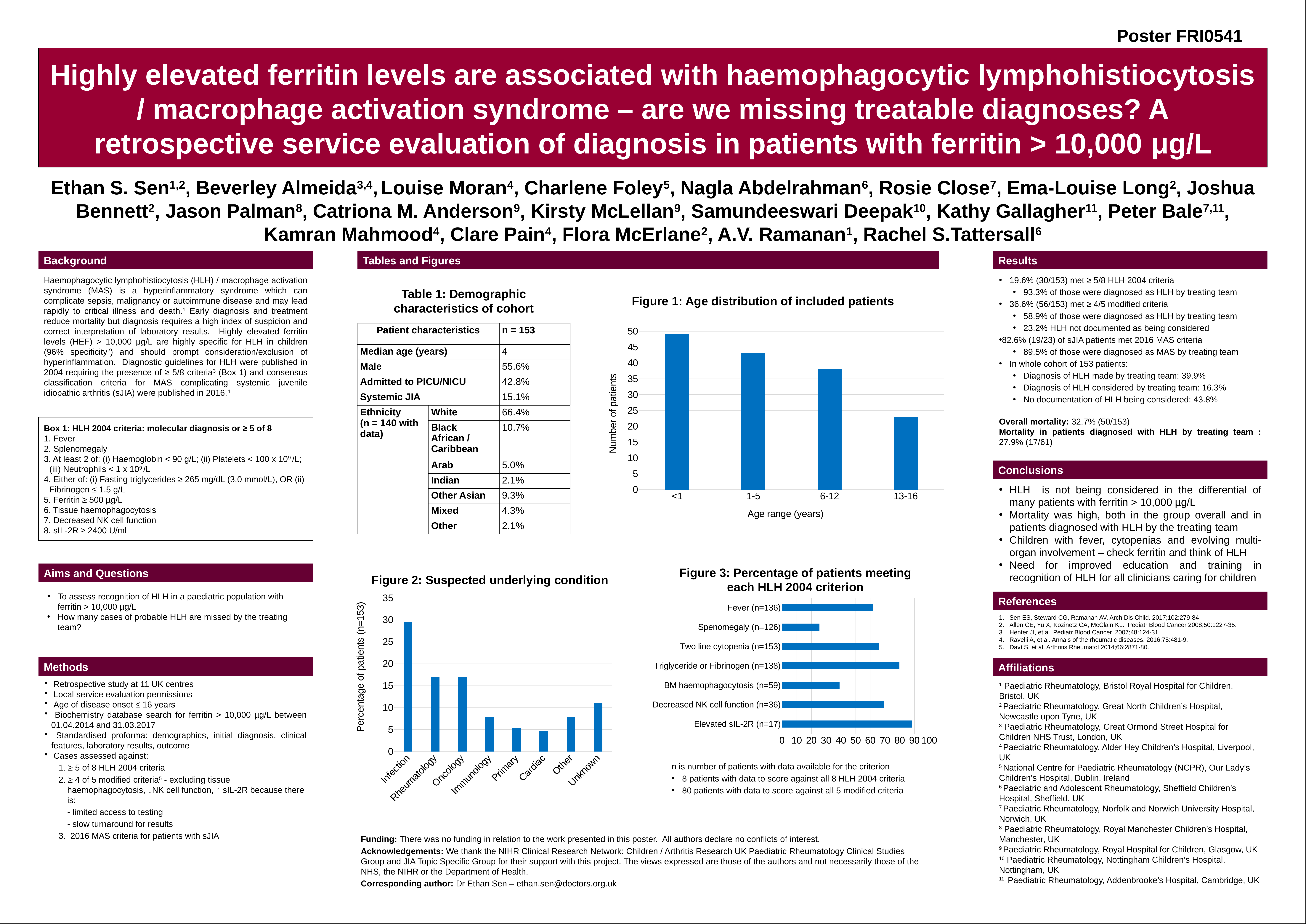
In Figure 1: Age distribution of included patients, do the values rise or fall as the age range increases along the x axis? fall In Figure 3: Percentage of patients meeting each HLH 2004 criterion, which criterion has the lowest percentage? Spenomegaly (n=126) In Figure 1: Age distribution of included patients, which age range has the highest number of patients? <1 In Figure 2: Suspected underlying condition, which condition has the highest percentage of patients? Infection In Figure 1: Age distribution of included patients, is the number of patients aged 13-16 greater or less than 25? less What kind of chart is Figure 3: Percentage of patients meeting each HLH 2004 criterion? bar chart In Figure 3: Percentage of patients meeting each HLH 2004 criterion, which criterion has the highest percentage? Elevated sIL-2R (n=17) In Figure 2: Suspected underlying condition, how many categories are shown on the x axis? 8 In Figure 2: Suspected underlying condition, is the value for Infection greater or less than 25? greater In Figure 2: Suspected underlying condition, which is larger, the value for Unknown or the value for Immunology? Unknown In Figure 1: Age distribution of included patients, which age range has the lowest number of patients? 13-16 In Figure 1: Age distribution of included patients, how many age ranges are plotted? 4